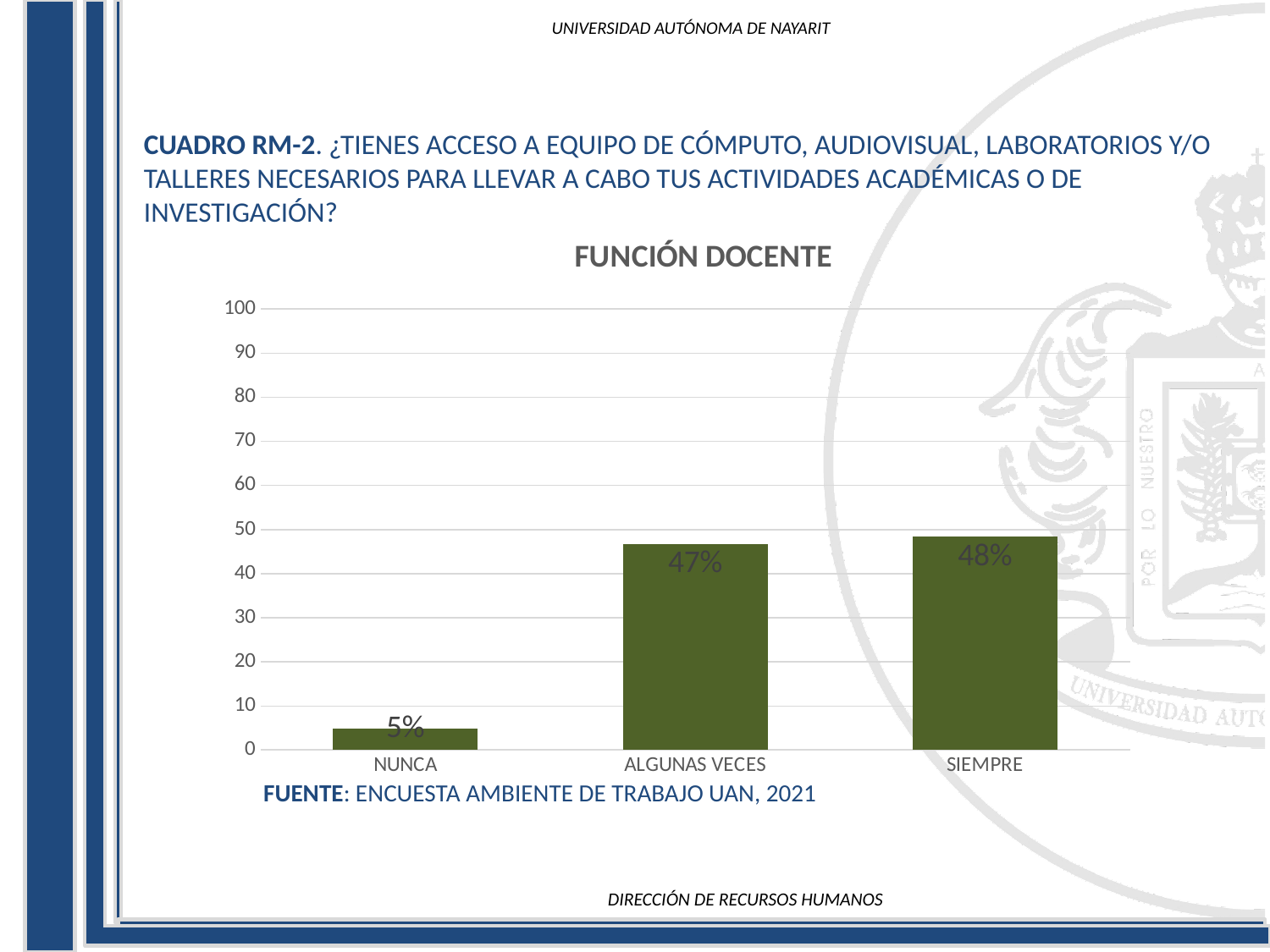
What is the value for NUNCA in the FUNCIÓN DOCENTE chart? 5% Is the value for SIEMPRE in the FUNCIÓN DOCENTE chart greater or less than 50? less What is the value for ALGUNAS VECES in the FUNCIÓN DOCENTE chart? 47% What kind of chart is the FUNCIÓN DOCENTE chart? bar chart How many categories are shown in the FUNCIÓN DOCENTE chart? 3 What is the difference between the values for ALGUNAS VECES and NUNCA in the FUNCIÓN DOCENTE chart? 42% What is the value for SIEMPRE in the FUNCIÓN DOCENTE chart? 48% What is the title of the chart on the slide? FUNCIÓN DOCENTE Which category has the highest value in the FUNCIÓN DOCENTE chart? SIEMPRE What is the difference between the values for SIEMPRE and NUNCA in the FUNCIÓN DOCENTE chart? 43% Which is larger in the FUNCIÓN DOCENTE chart, the value for NUNCA or the value for ALGUNAS VECES? ALGUNAS VECES Which category has the lowest value in the FUNCIÓN DOCENTE chart? NUNCA